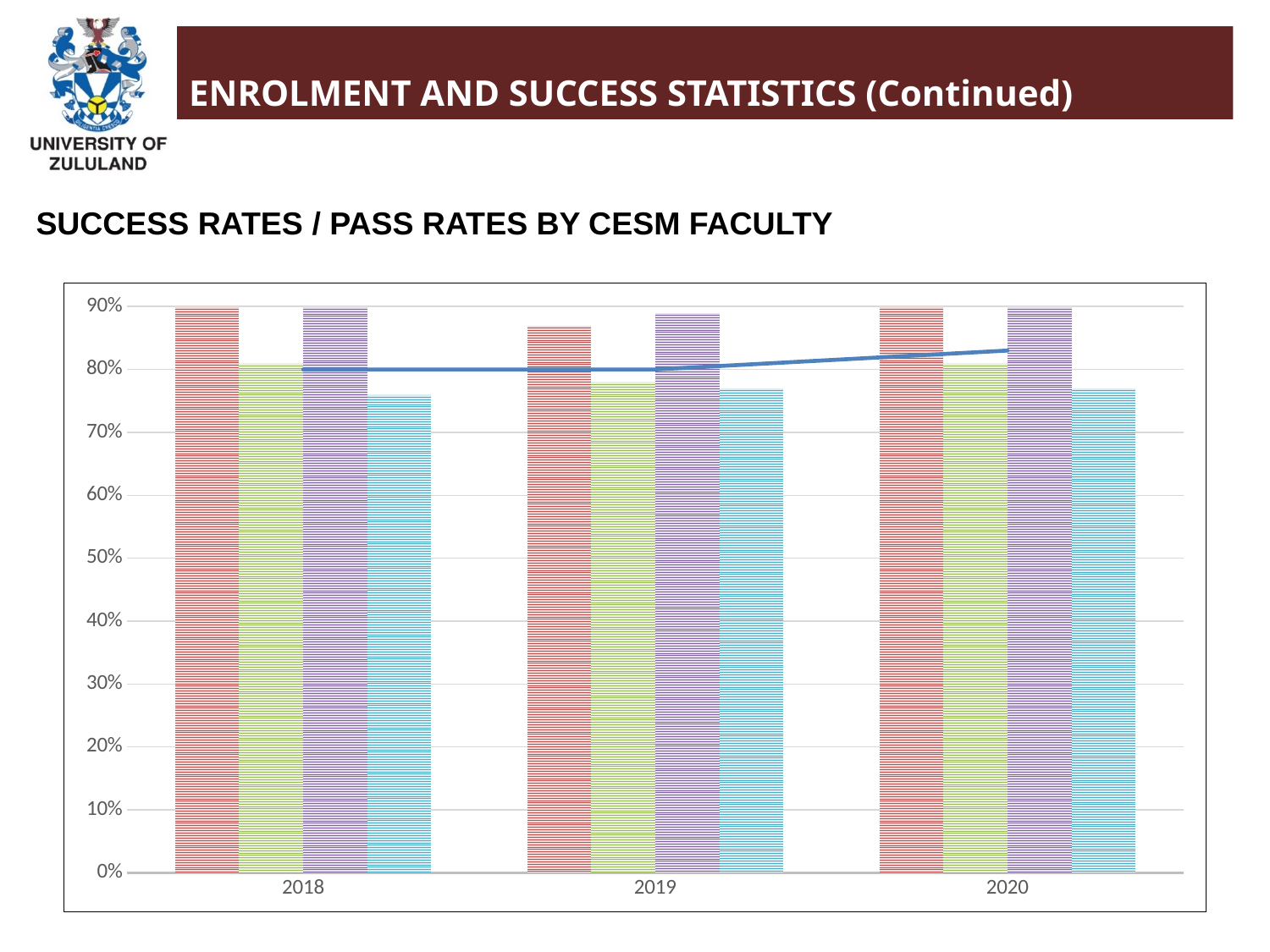
How many years are shown on the x axis of the chart? 3 Is the value of the purple bar for 2019 greater or less than 80%? greater Is the value of the red bar for 2018 greater or less than 80%? greater Is the value of the cyan bar for 2018 greater or less than 80%? less How many bars are plotted for each year in the chart? 4 Which bar is the lowest for 2020? the cyan bar What kind of chart is shown on the slide? bar and line chart Does the line plotted across the chart rise or fall from 2018 to 2020? rise For 2018, which is larger: the red bar or the cyan bar? the red bar What is the title printed above the chart? SUCCESS RATES / PASS RATES BY CESM FACULTY